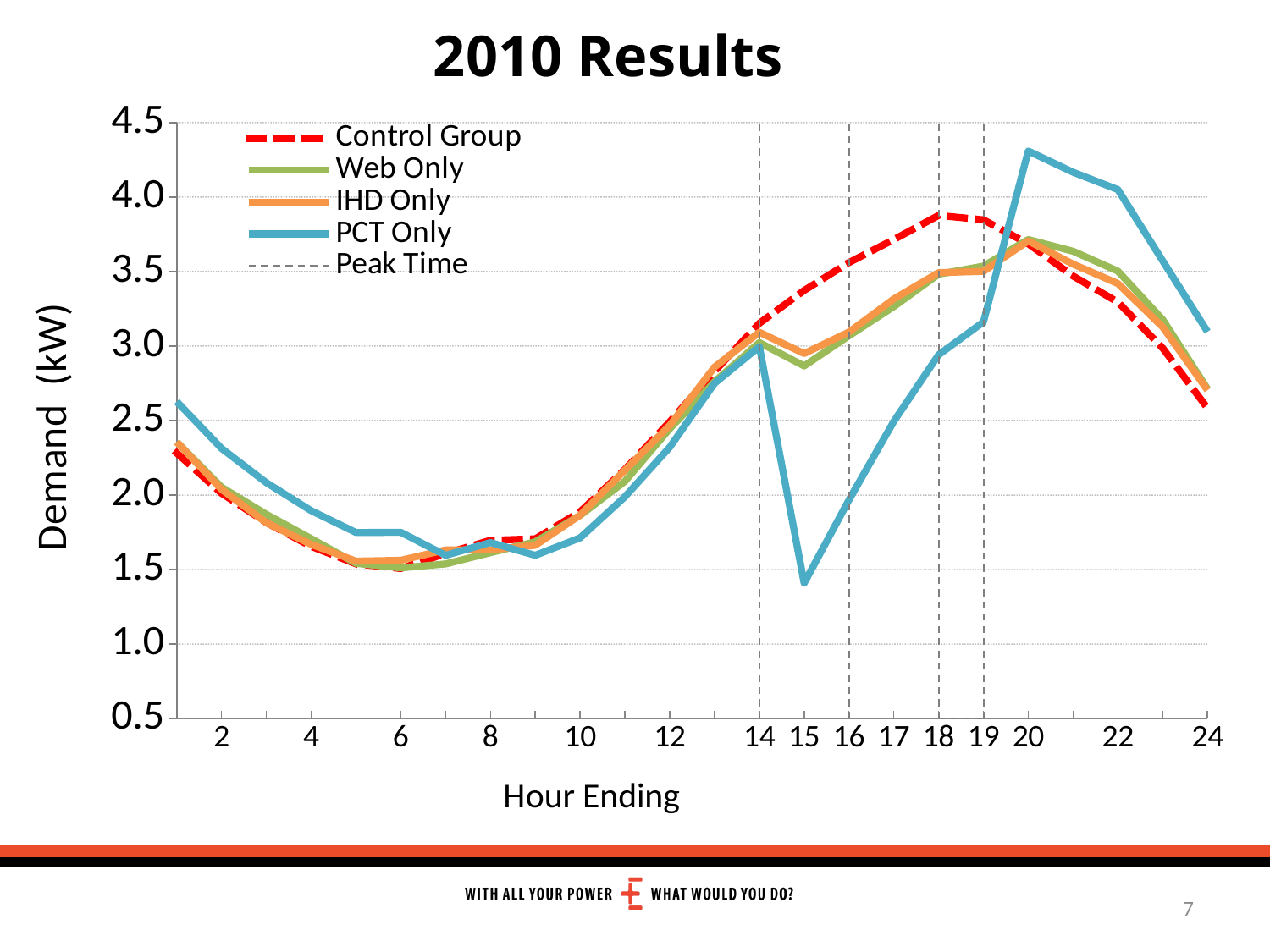
At hour ending 15, which series has the higher demand, Control Group or PCT Only? Control Group Is the value for Control Group at hour ending 24 greater or less than 3.0? less Is the value for Control Group at hour ending 18 greater or less than 3.5? greater How many entries does the chart legend list? 5 Does the Control Group line rise or fall between hour ending 1 and hour ending 5? Falls At which hour ending does the PCT Only line reach its lowest value? 15 Is the value for PCT Only at hour ending 15 greater or less than 2.0? less What kind of chart is shown on the slide? Line chart What is the title of the vertical axis? Demand (kW) Does the Control Group line rise or fall between hour ending 10 and hour ending 18? Rises At hour ending 20, which series has the higher demand, PCT Only or Control Group? PCT Only